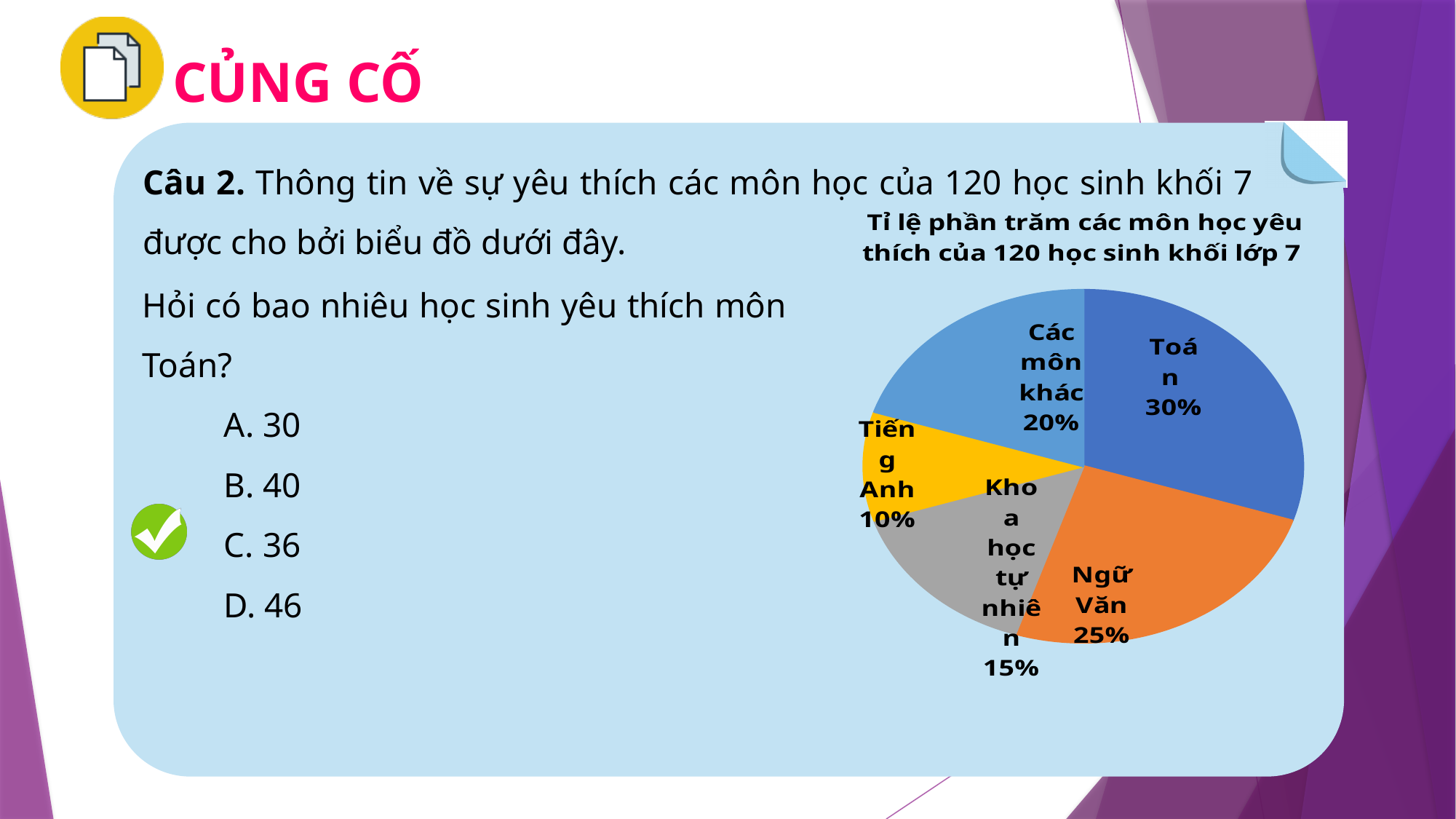
What is the title of the chart? Tỉ lệ phần trăm các môn học yêu thích của 120 học sinh khối lớp 7 How many slices does the pie chart have? 5 What is the difference in percentage points between Toán and Ngữ Văn? 5% Which subject has the largest slice of the pie chart? Toán What percentage is labelled for Tiếng Anh? 10% What percentage does the Ngữ Văn slice represent? 25% What type of chart is shown on the slide? Pie chart What share of the pie is Các môn khác? 20% Which subject has the smallest slice of the pie chart? Tiếng Anh Which is larger, the slice for Các môn khác or the slice for Khoa học tự nhiên? Các môn khác What percentage of the pie chart is the Toán slice? 30% What is the value shown for Khoa học tự nhiên? 15%